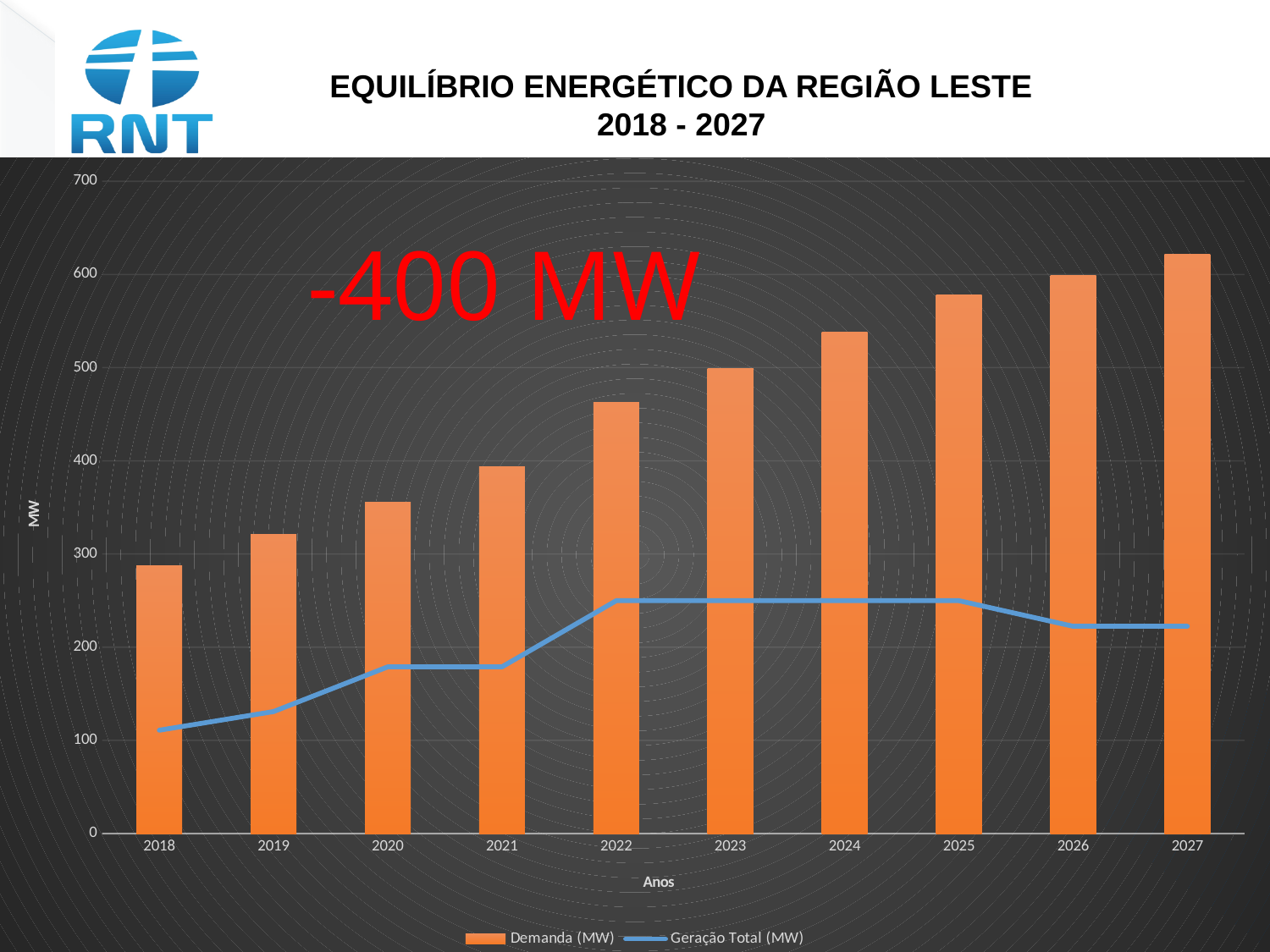
What is the title of the vertical axis of the chart? MW Is the Demanda (MW) value for 2027 greater or less than 600? greater In which year is Demanda (MW) highest? 2027 How many series does the chart legend list? 2 Is the Geração Total (MW) value for 2018 greater or less than 200? less Does Demanda (MW) rise or fall from 2018 to 2027? Rise In 2027, which is larger: Demanda (MW) or Geração Total (MW)? Demanda (MW) Is the Demanda (MW) value for 2018 greater or less than 300? less In which year is Demanda (MW) lowest? 2018 What kind of chart is shown on the slide? A combination bar and line chart How many years are shown on the x axis of the chart? 10